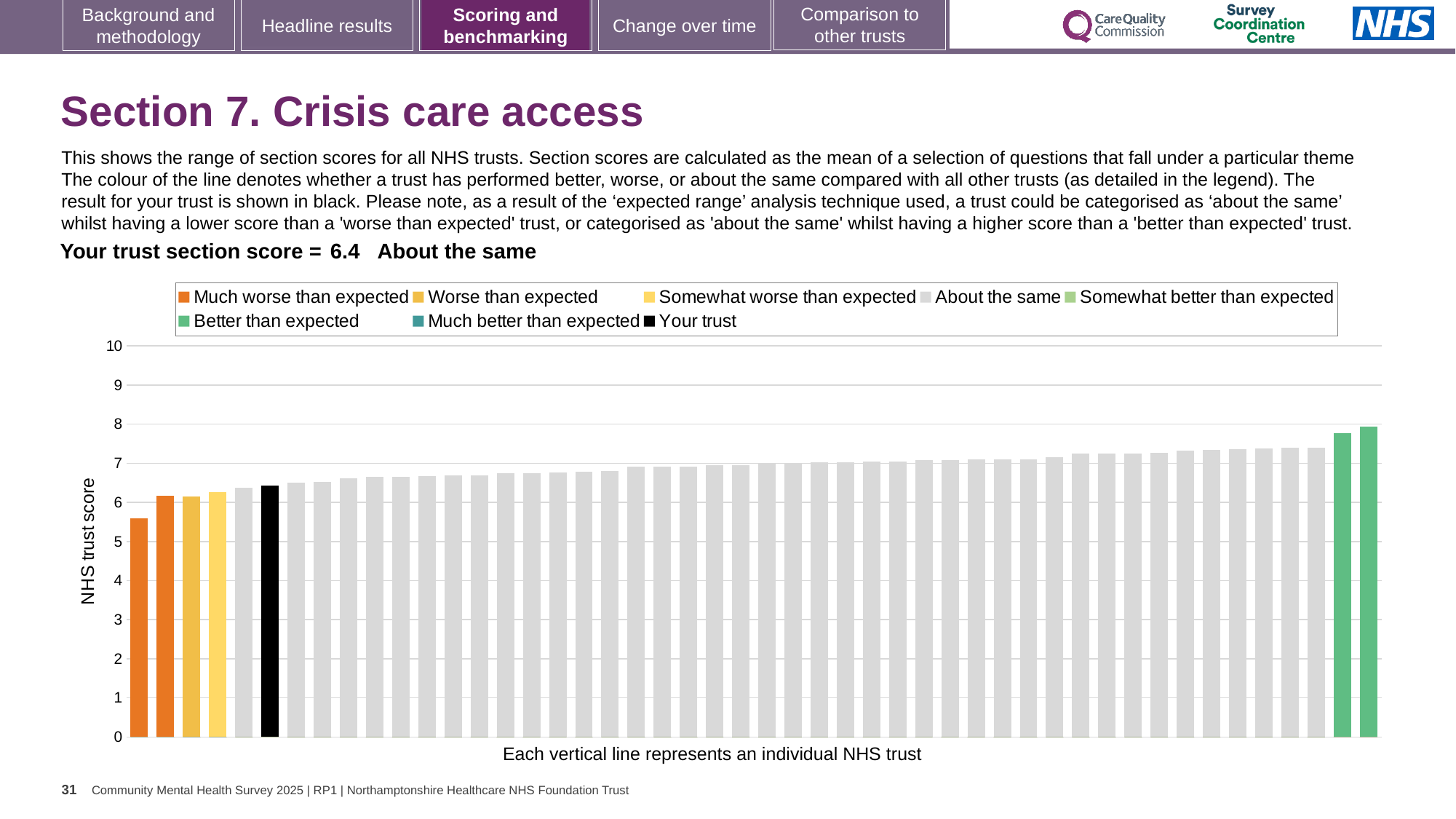
How many bars are coloured orange (Much worse than expected)? 2 What colour is the bar representing your trust? black Which performance category is your trust placed in for crisis care access? About the same Is the value of the lowest bar (the first orange bar) greater or less than 6? less How many entries does the chart legend list? 8 Do the bar values rise or fall from left to right along the x axis? rise Is the value of the tallest bar greater or less than 7? greater What is the label on the vertical axis of the chart? NHS trust score Is the value of the black 'Your trust' bar greater or less than 6? greater What kind of chart is shown on the slide? bar chart What is the section score for your trust shown on the slide? 6.4